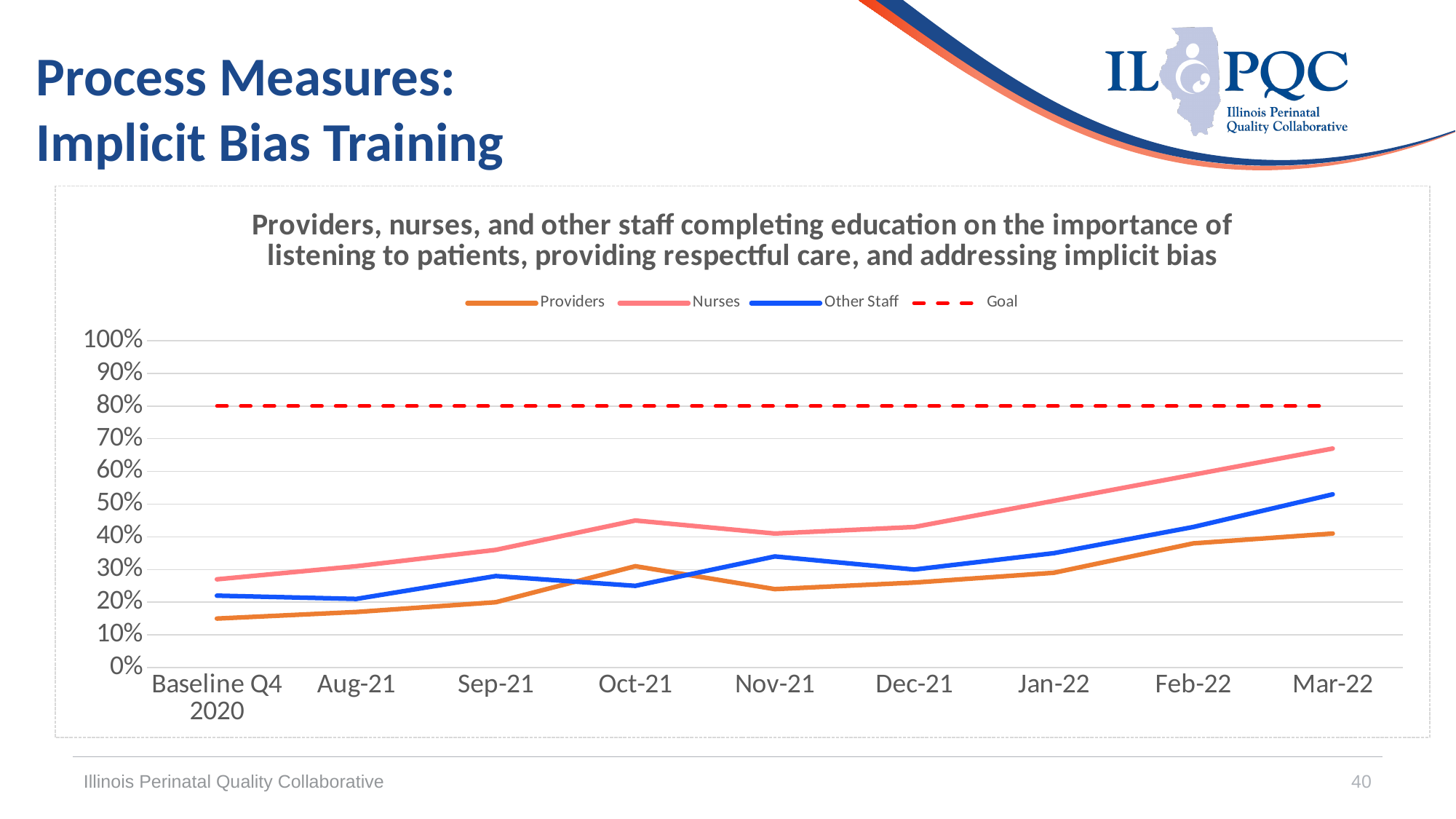
Do the Nurses values rise or fall from Dec-21 to Mar-22? rise What kind of chart is shown on the slide? line chart At what percentage is the Goal line drawn? 80% Is the value for Nurses at Oct-21 greater or less than 40%? greater Which series has the lowest value at Baseline Q4 2020? Providers Which series is drawn as a red dashed line? Goal Which series has the highest value at Mar-22? Nurses Is the value for Providers at Baseline Q4 2020 greater or less than 20%? less How many series does the legend list? 4 How many time points are shown along the x axis? 9 At Mar-22, which is larger: the value for Other Staff or the value for Providers? Other Staff Is the value for Nurses at Mar-22 greater or less than 60%? greater